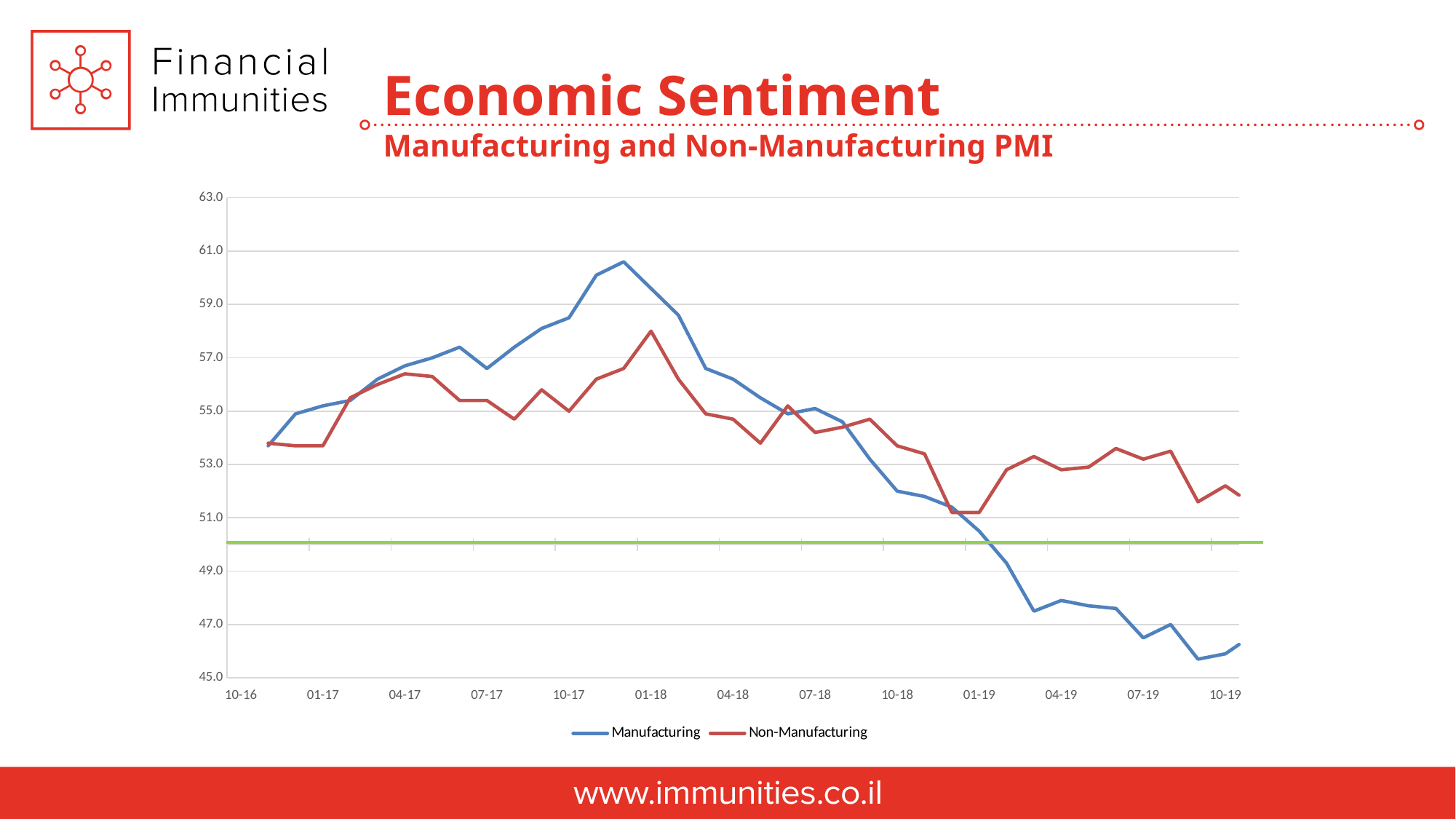
Is the Manufacturing value at 10-19 greater or less than 47.0? less At 10-17, which series has the higher value, Manufacturing or Non-Manufacturing? Manufacturing Does the Manufacturing series rise or fall between 01-18 and 10-19? Fall At 10-19, which series has the higher value, Manufacturing or Non-Manufacturing? Non-Manufacturing What kind of chart is shown on the slide? Line chart Is the Non-Manufacturing value at 10-19 greater or less than 51.0? greater How many date labels are shown on the x axis? 13 What are the two series named in the legend? Manufacturing and Non-Manufacturing Is the Non-Manufacturing value at 01-18 greater or less than 57.0? greater How many series does the legend list? 2 What is the subtitle of the chart below 'Economic Sentiment'? Manufacturing and Non-Manufacturing PMI